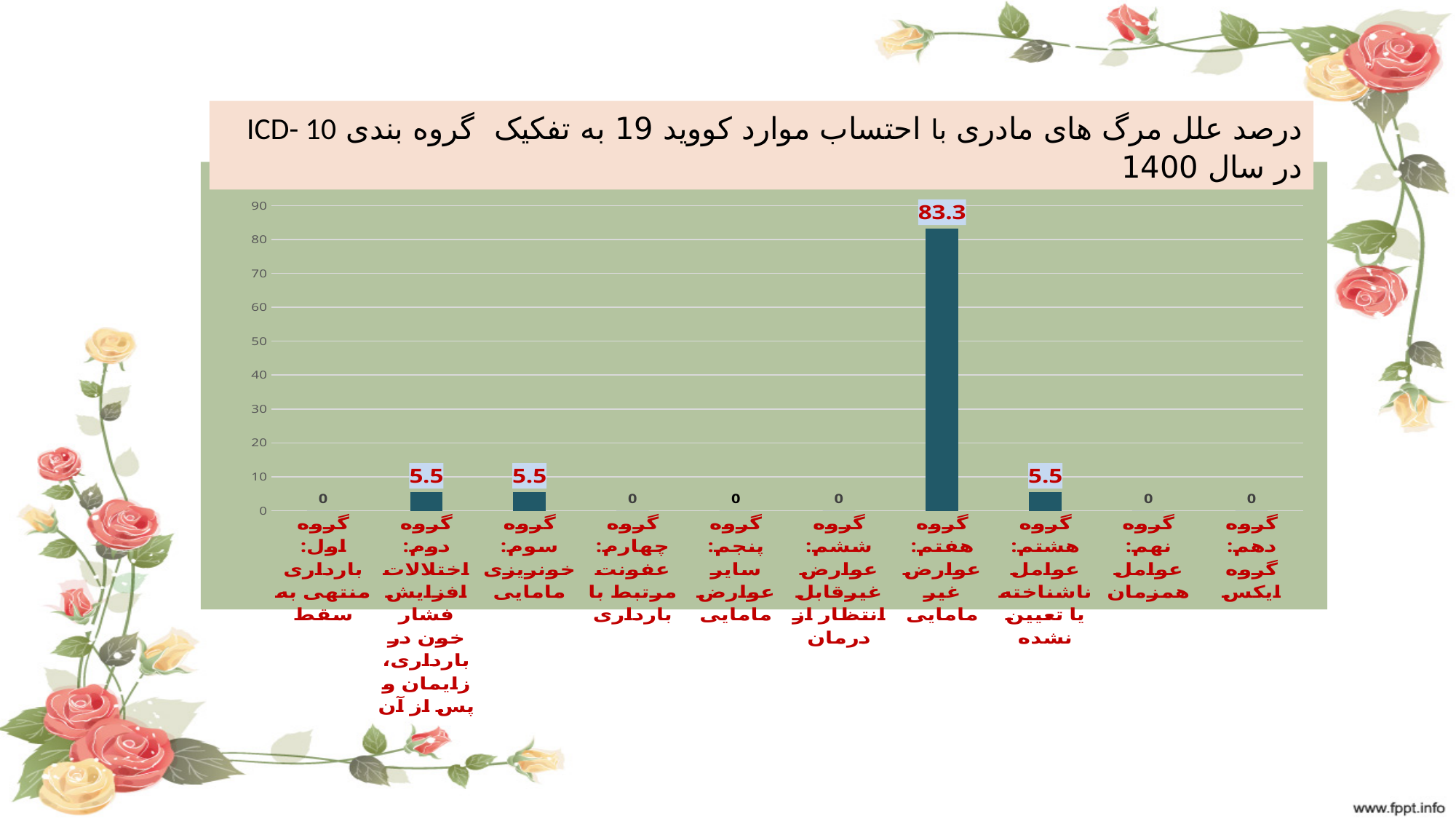
How many categories are shown on the x axis? 10 Which is larger, the value for گروه دوم or the value for گروه چهارم: عفونت مرتبط با بارداری? گروه دوم What is the value for گروه هشتم: عوامل ناشناخته یا تعیین نشده? 5.5 Which category has the highest value? گروه هفتم: عوارض غیر مامایی What is the value for گروه هفتم: عوارض غیر مامایی? 83.3 What is the value for گروه سوم: خونریزی مامایی? 5.5 How many categories have a value of 0? 6 What is the highest tick value shown on the vertical axis? 90 What is the difference between the values for گروه هفتم: عوارض غیر مامایی and گروه دوم: اختلالات افزایش فشار خون در بارداری، زایمان و پس از آن? 77.8 Is the value for گروه هفتم: عوارض غیر مامایی greater or less than 80? greater What kind of chart is shown on the slide? bar chart What is the value for گروه اول: بارداری منتهی به سقط? 0